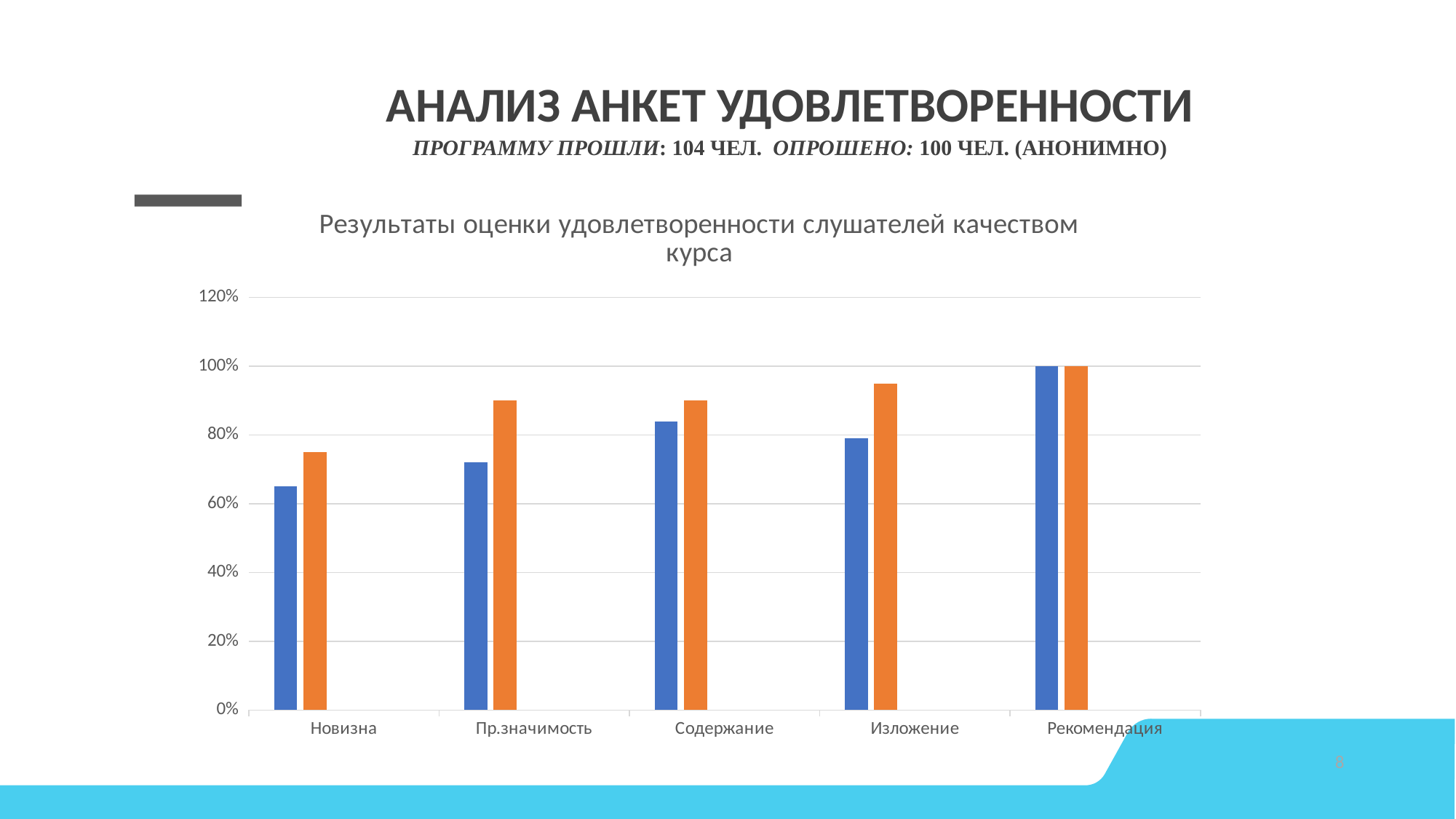
Do the blue bar values generally rise or fall from Новизна to Рекомендация? rise What kind of chart is shown on the slide? bar chart Is the orange bar for Пр.значимость greater or less than 80%? greater Is the blue bar for Новизна greater or less than 60%? greater What is the title of the chart? Результаты оценки удовлетворенности слушателей качеством курса For Новизна, which bar is larger, the blue one or the orange one? orange Which category has the highest values for both bars? Рекомендация What is the value of the orange bar for Рекомендация? 100% What is the value of the blue bar for Рекомендация? 100% Which category has the lowest blue bar? Новизна How many bars are plotted for each category? 2 How many categories are shown on the x axis of the chart? 5